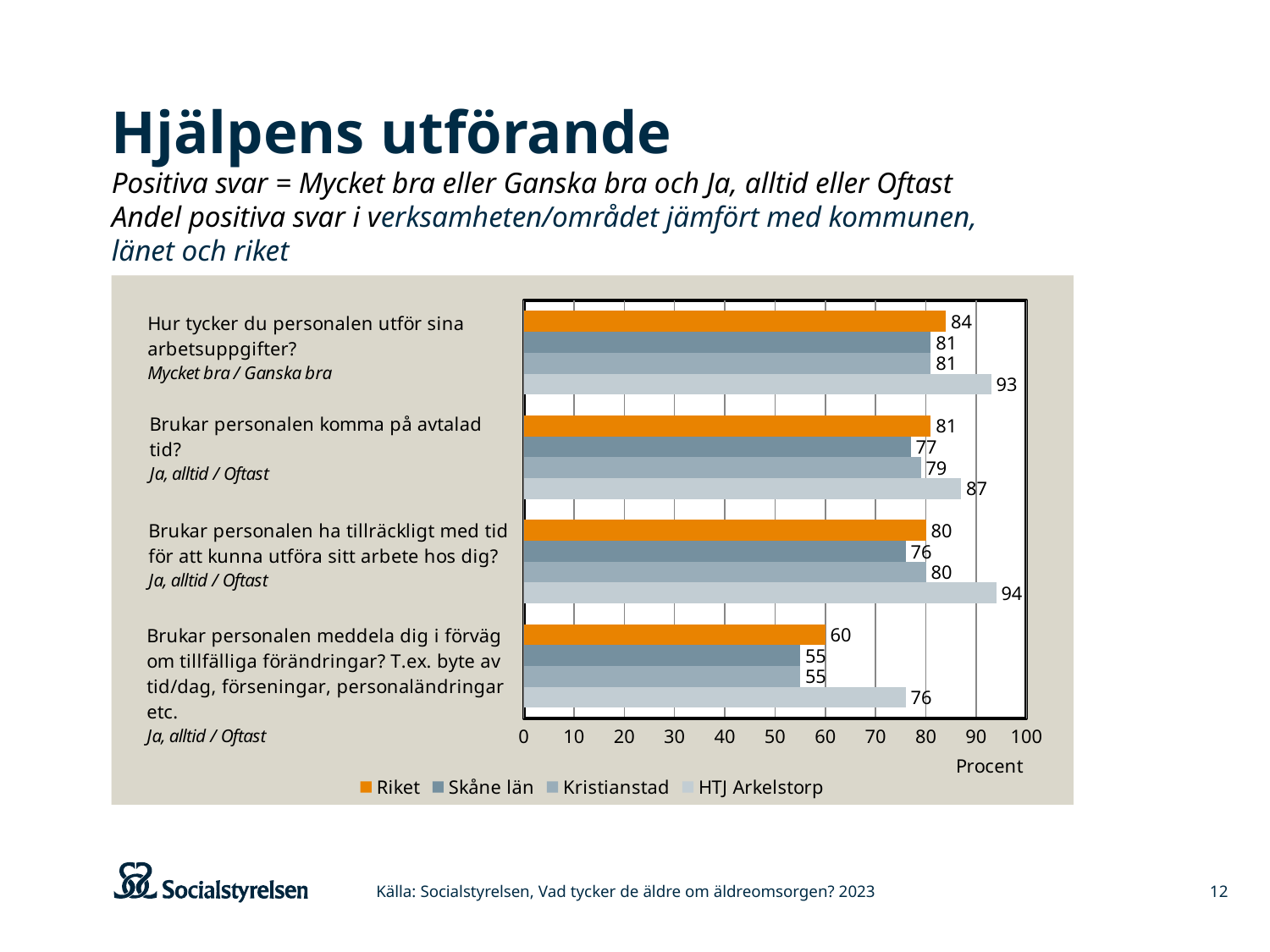
Which series has the highest value on the question "Brukar personalen ha tillräckligt med tid för att kunna utföra sitt arbete hos dig?"? HTJ Arkelstorp What is the value for HTJ Arkelstorp on the question "Hur tycker du personalen utför sina arbetsuppgifter?"? 93 What is the value for Skåne län on the question "Brukar personalen ha tillräckligt med tid för att kunna utföra sitt arbete hos dig?"? 76 Which is larger on the question "Brukar personalen komma på avtalad tid?": Skåne län or Kristianstad? Kristianstad What is the difference between HTJ Arkelstorp and Riket on the question "Brukar personalen meddela dig i förväg om tillfälliga förändringar?"? 16 How many series does the legend list? 4 What kind of chart is shown on the slide? Bar chart What is the value for Kristianstad on the question "Brukar personalen meddela dig i förväg om tillfälliga förändringar?"? 55 Is the value for HTJ Arkelstorp on the question "Brukar personalen komma på avtalad tid?" greater or less than 80? greater What is the value for Riket on the question "Brukar personalen komma på avtalad tid?"? 81 Which question has the lowest value for Riket? Brukar personalen meddela dig i förväg om tillfälliga förändringar? How many questions (categories) are shown in the chart? 4